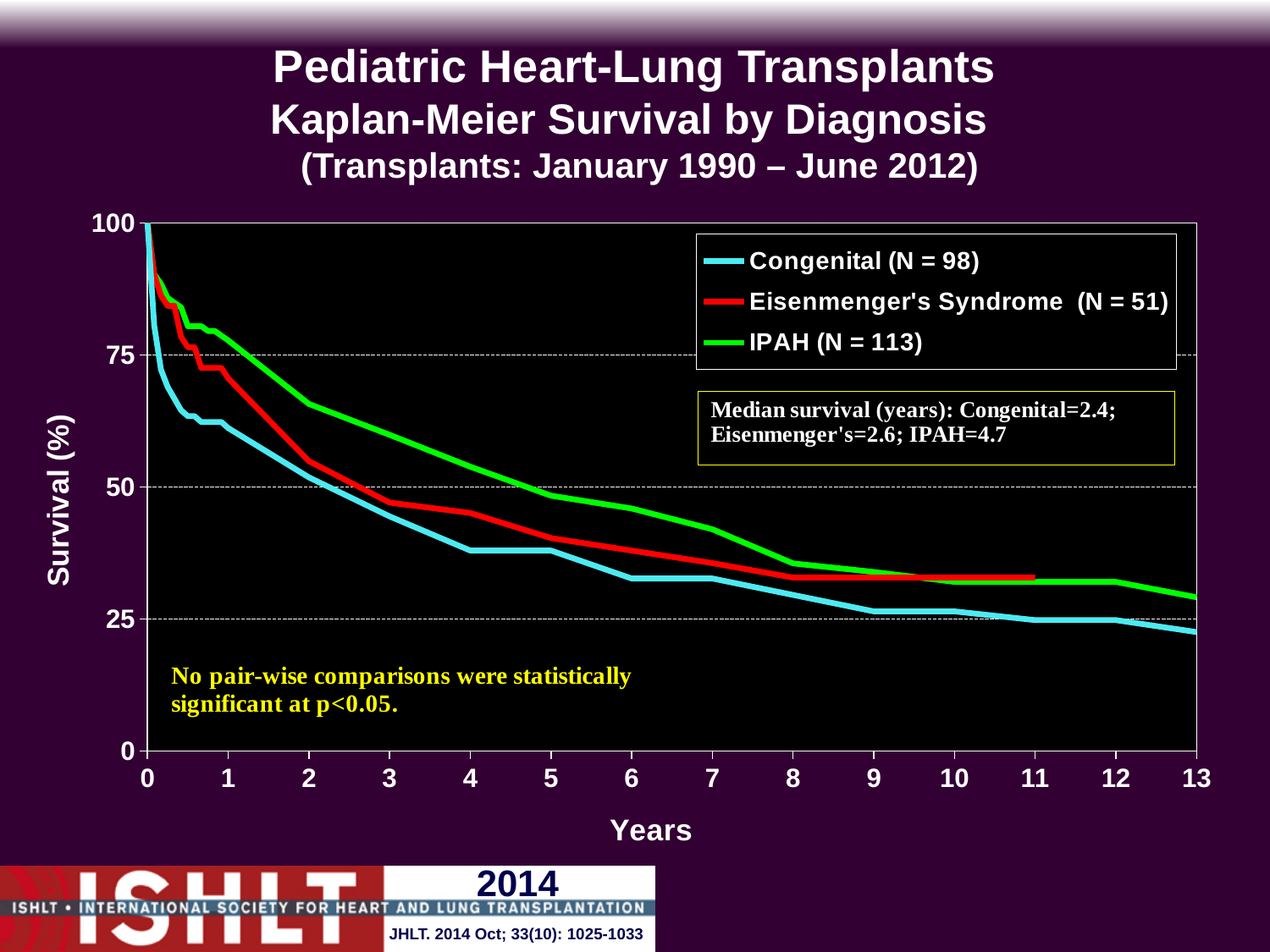
Which diagnosis group has the lowest median survival? Congenital What is the difference in median survival (years) between IPAH and Congenital? 2.3 What kind of chart is shown on the slide? Line chart What is the median survival in years for the IPAH group? 4.7 Do the survival curves rise or fall as years increase? Fall How many series does the legend list? 3 What is the N for the Congenital group shown in the legend? 98 Is the survival for the IPAH group at 3 years greater or less than 50? greater At 5 years, which group has higher survival, IPAH or Congenital? IPAH Is the survival for the Congenital group at 1 year greater or less than 75? less What is the N for the Eisenmenger's Syndrome group shown in the legend? 51 Which diagnosis group has the highest median survival? IPAH